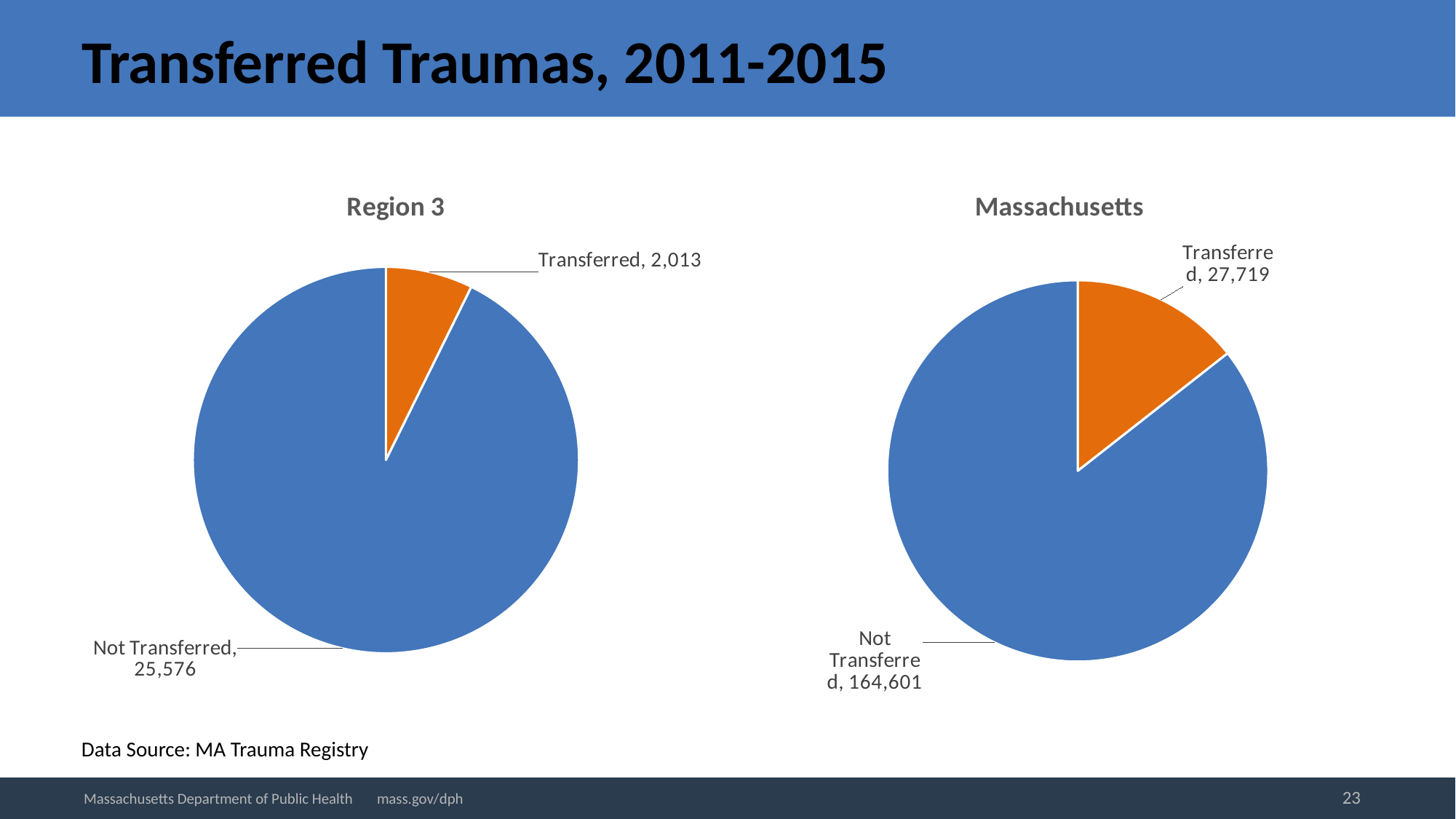
In the Massachusetts pie chart, which slice is the smallest? Transferred What type of chart is used for Region 3? Pie chart In the Massachusetts pie chart, how many traumas were Transferred? 27,719 In the Region 3 pie chart, how many traumas were Transferred? 2,013 In the Region 3 pie chart, what colour is the Transferred slice? Orange In the Region 3 pie chart, which slice is the largest? Not Transferred In the Massachusetts pie chart, what is the difference between the Not Transferred and Transferred counts? 136,882 In the Region 3 pie chart, what is the difference between the Not Transferred and Transferred counts? 23,563 In the Massachusetts pie chart, how many traumas were Not Transferred? 164,601 Which is larger: the Transferred count in the Region 3 chart or the Transferred count in the Massachusetts chart? Massachusetts In the Region 3 pie chart, how many traumas were Not Transferred? 25,576 How many slices does the Massachusetts pie chart have? 2